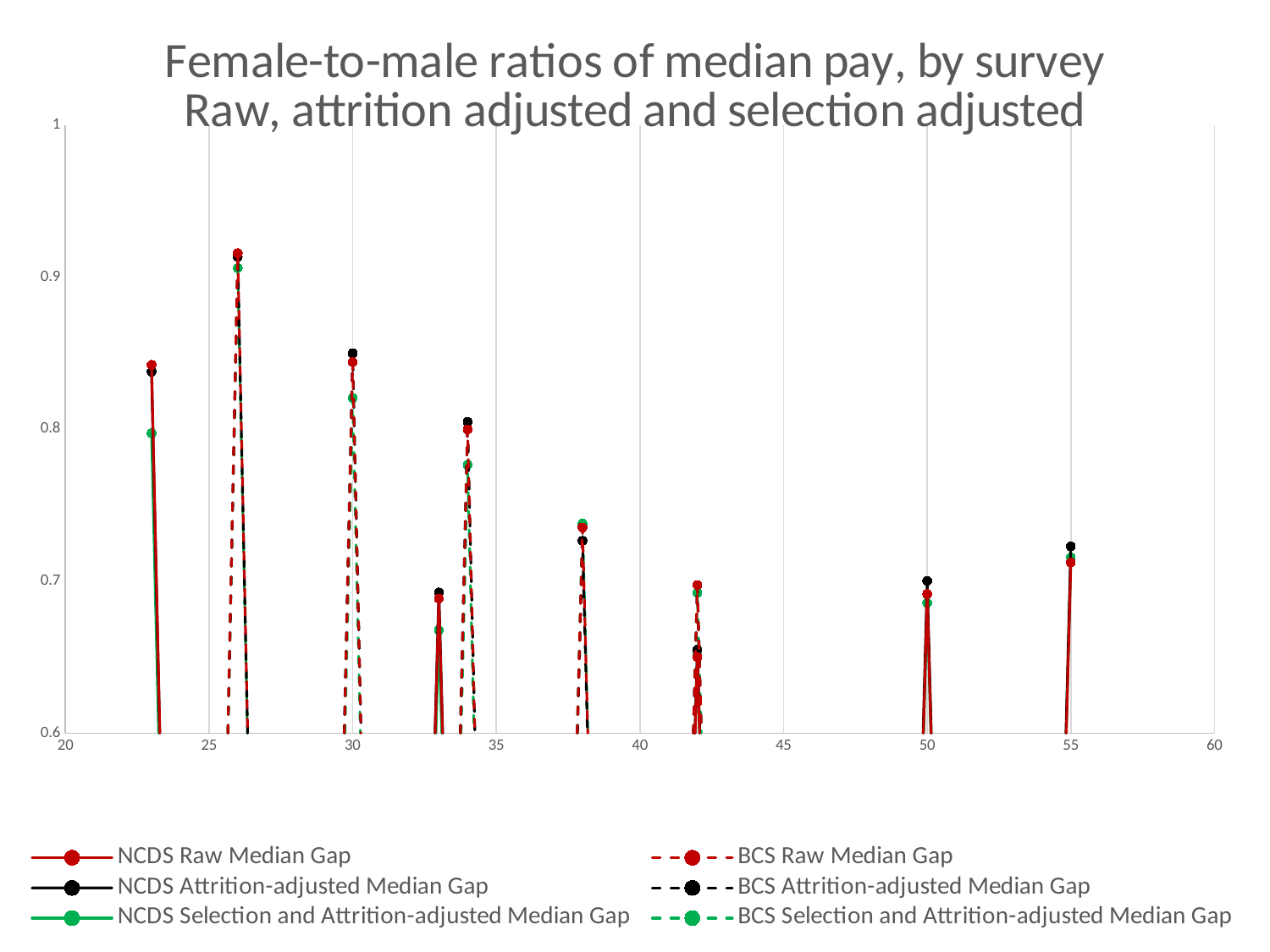
How many series does the legend list? 6 Which is larger, the BCS Raw Median Gap at age 26 or the NCDS Raw Median Gap at age 55? BCS Raw Median Gap at age 26 What kind of chart is shown on the slide? line chart What colour are the Selection and Attrition-adjusted Median Gap series drawn in? green Is the NCDS Raw Median Gap value at age 23 greater or less than 0.8? greater Is the BCS Raw Median Gap value at age 34 greater or less than 0.9? less Is the NCDS Raw Median Gap value at age 33 greater or less than 0.7? less At which age on the x axis do the plotted ratios reach their highest point? 26 Do the plotted ratios generally rise or fall as age increases from 26 to 55? fall What is the first line of the chart title? Female-to-male ratios of median pay, by survey